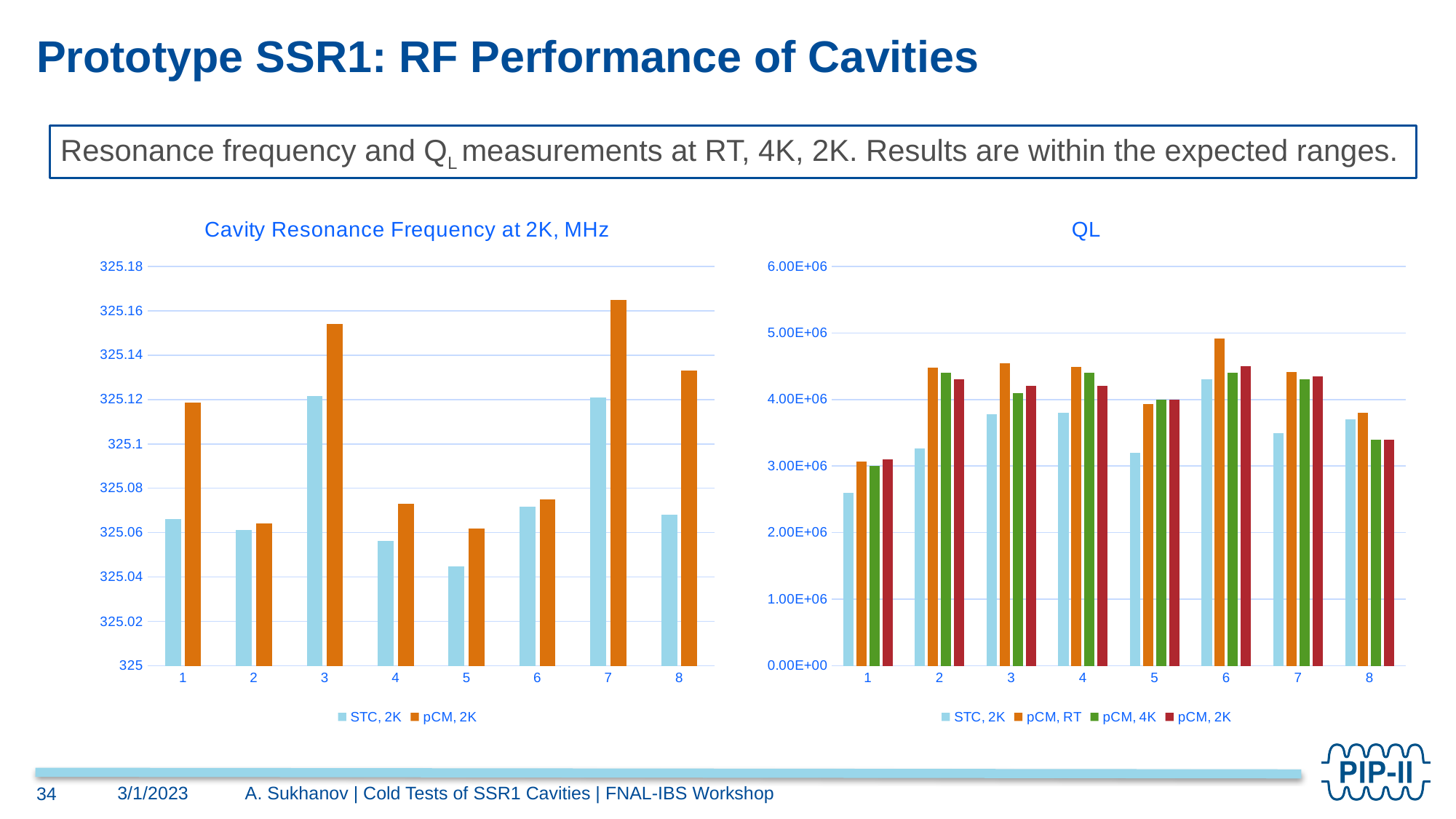
What type of chart is the 'Cavity Resonance Frequency at 2K, MHz' chart? bar chart How many cavities (categories) are shown on the x axis of the 'QL' chart? 8 In the 'Cavity Resonance Frequency at 2K, MHz' chart, which cavity has the lowest STC, 2K value? 5 How many series does the legend of the 'Cavity Resonance Frequency at 2K, MHz' chart list? 2 In the 'QL' chart, which cavity has the highest pCM, RT value? 6 In the 'QL' chart, which series is shown in green according to the legend? pCM, 4K In the 'QL' chart, is the STC, 2K value for cavity 1 greater or less than 3.00E+06? less In the 'Cavity Resonance Frequency at 2K, MHz' chart, for cavity 1, which series has the larger value: STC, 2K or pCM, 2K? pCM, 2K How many series does the legend of the 'QL' chart list? 4 In the 'QL' chart, is the pCM, RT value for cavity 6 greater or less than 4.00E+06? greater In the 'QL' chart, which cavity has the lowest STC, 2K value? 1 In the 'Cavity Resonance Frequency at 2K, MHz' chart, which cavity has the highest pCM, 2K value? 7